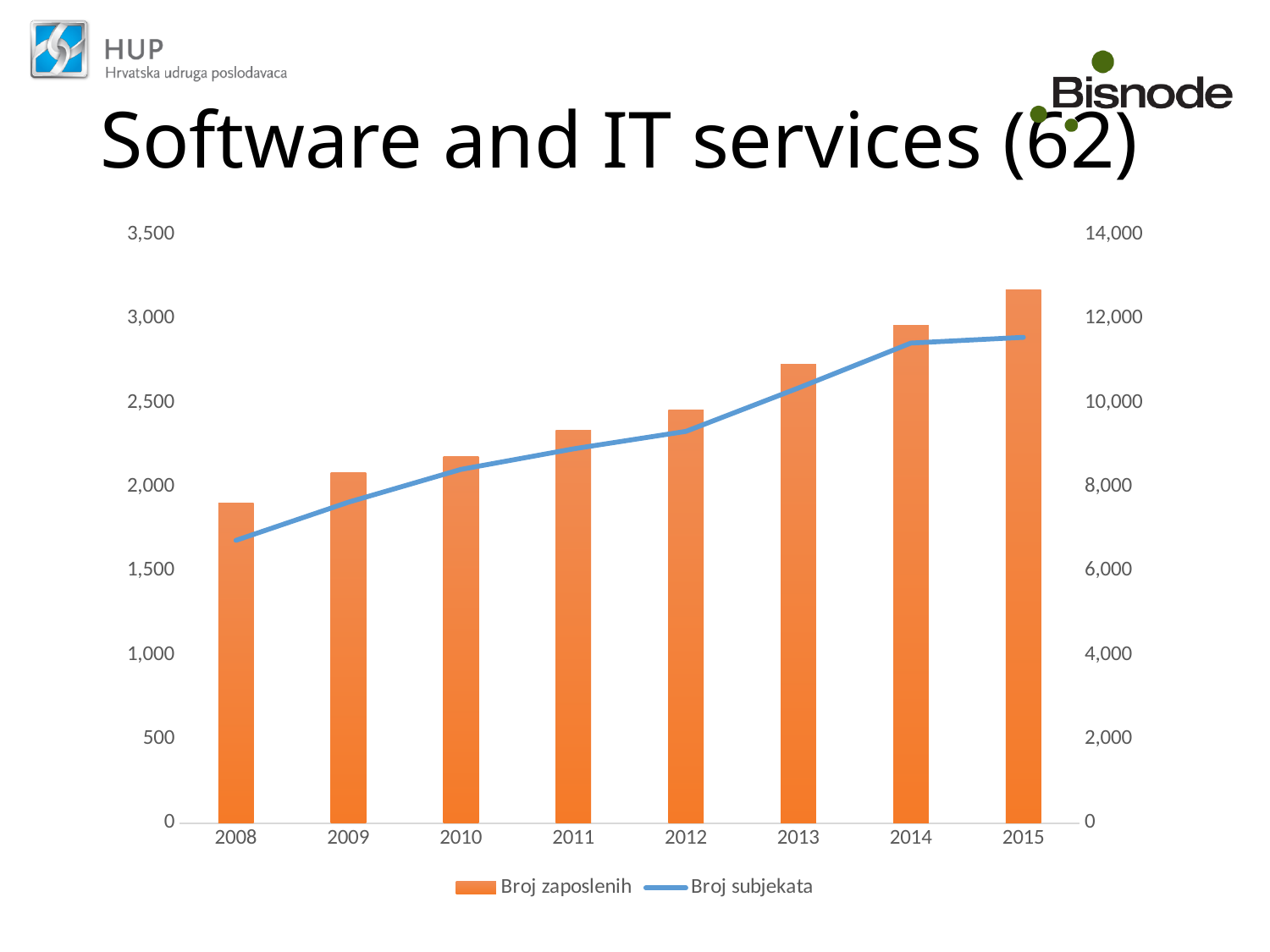
Which year has the shortest bar? 2008 How many years are shown on the x axis of the chart? 8 Which series is drawn as a line? Broj subjekata What kind of chart is shown on the slide? A combined bar and line chart Which bar is taller, 2012 or 2014? 2014 Do the bars rise or fall from 2008 to 2015? Rise What are the two series named in the legend? Broj zaposlenih and Broj subjekata Which year has the tallest bar? 2015 Does the Broj subjekata line rise or fall from 2008 to 2015? Rise How many series does the chart legend list? 2